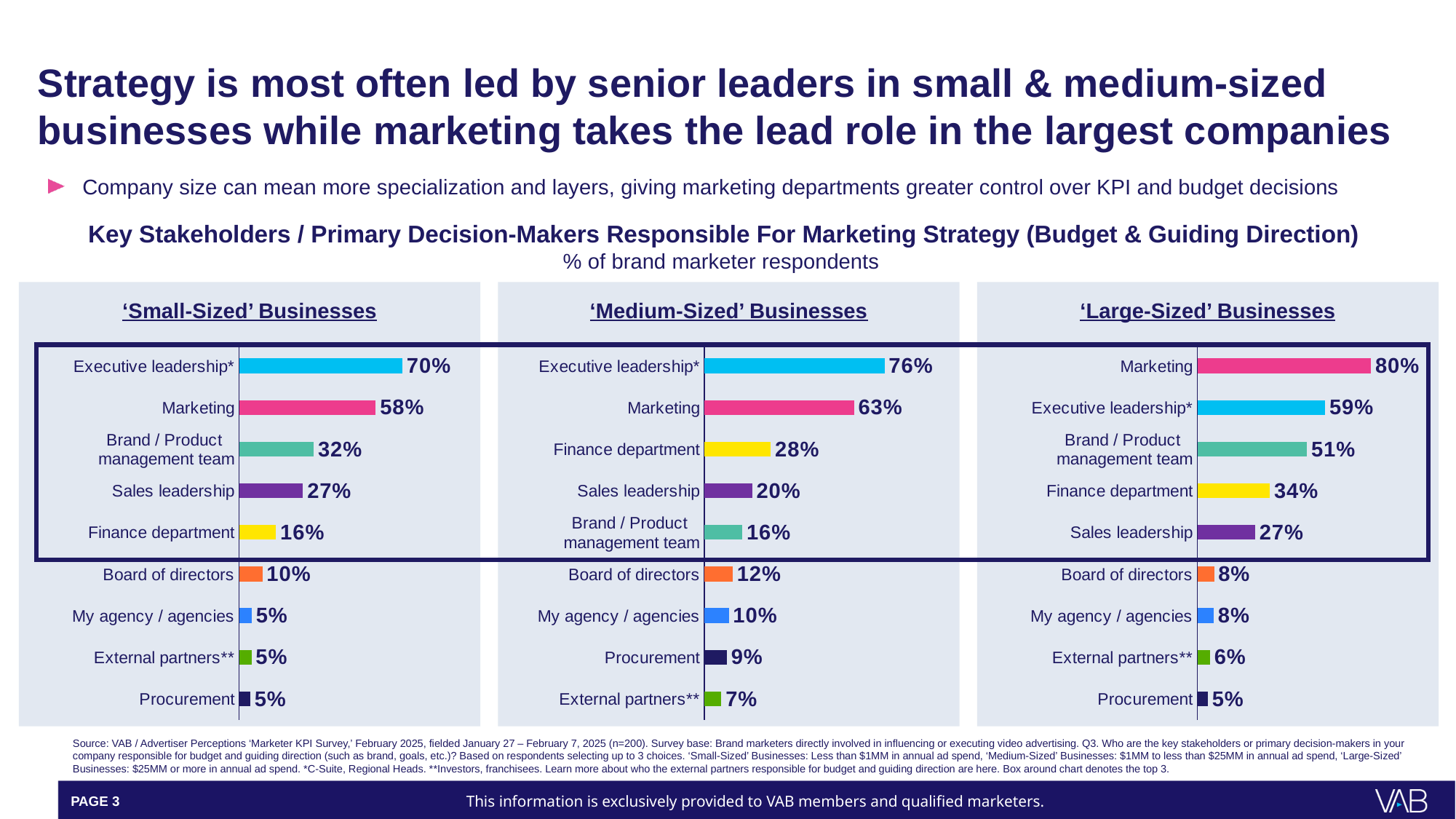
In the 'Large-Sized' Businesses chart, what is the value for Brand / Product management team? 51% In the 'Large-Sized' Businesses chart, what is the value for Procurement? 5% How many separate charts are shown on the slide? 3 In the 'Large-Sized' Businesses chart, which category has the highest value? Marketing In the 'Large-Sized' Businesses chart, what is the difference between Marketing and Executive leadership*? 21% In the 'Small-Sized' Businesses chart, what is the value for Executive leadership*? 70% In the 'Medium-Sized' Businesses chart, what is the difference between Executive leadership* and Marketing? 13% How many categories are shown in the 'Small-Sized' Businesses chart? 9 In the 'Medium-Sized' Businesses chart, what is the value for Finance department? 28% In the 'Small-Sized' Businesses chart, which is larger: Sales leadership or Finance department? Sales leadership What kind of chart is used for the 'Medium-Sized' Businesses data? Bar chart In the 'Medium-Sized' Businesses chart, which category has the lowest value? External partners**